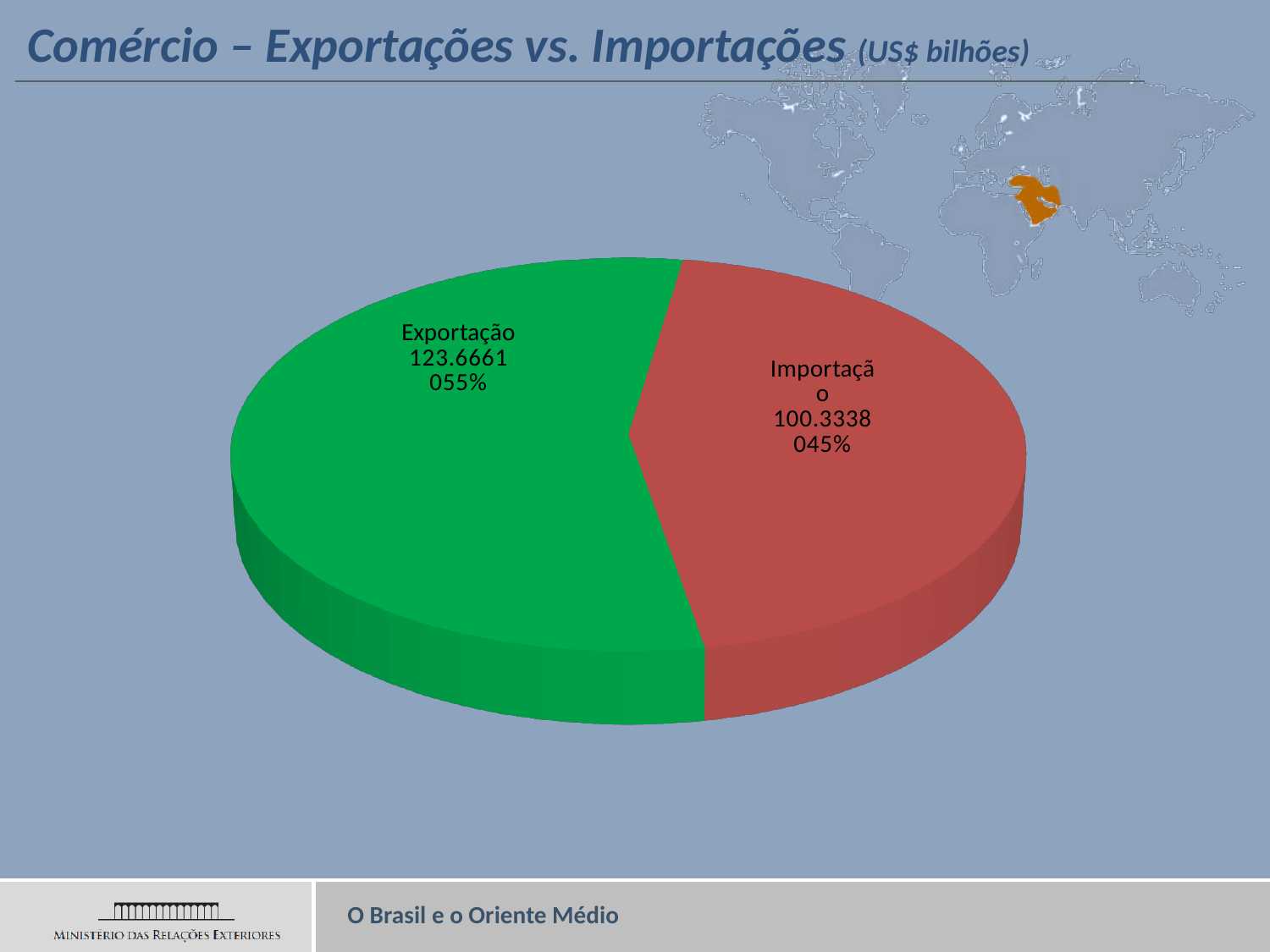
What is the value shown for Importação in the pie chart? 100.3338 Which is larger, Exportação or Importação? Exportação What colour is the Importação slice of the pie chart? Red What is the difference between the Exportação value and the Importação value? 23.3323 What unit is given in the slide title for the chart values? US$ bilhões What percentage share of the pie does the Exportação slice represent? 055% Which slice of the pie chart is the largest? Exportação Which slice of the pie chart is the smallest? Importação How many slices does the pie chart have? 2 What type of chart is shown on the slide? Pie chart What percentage share of the pie does the Importação slice represent? 045% What is the value shown for Exportação in the pie chart? 123.6661